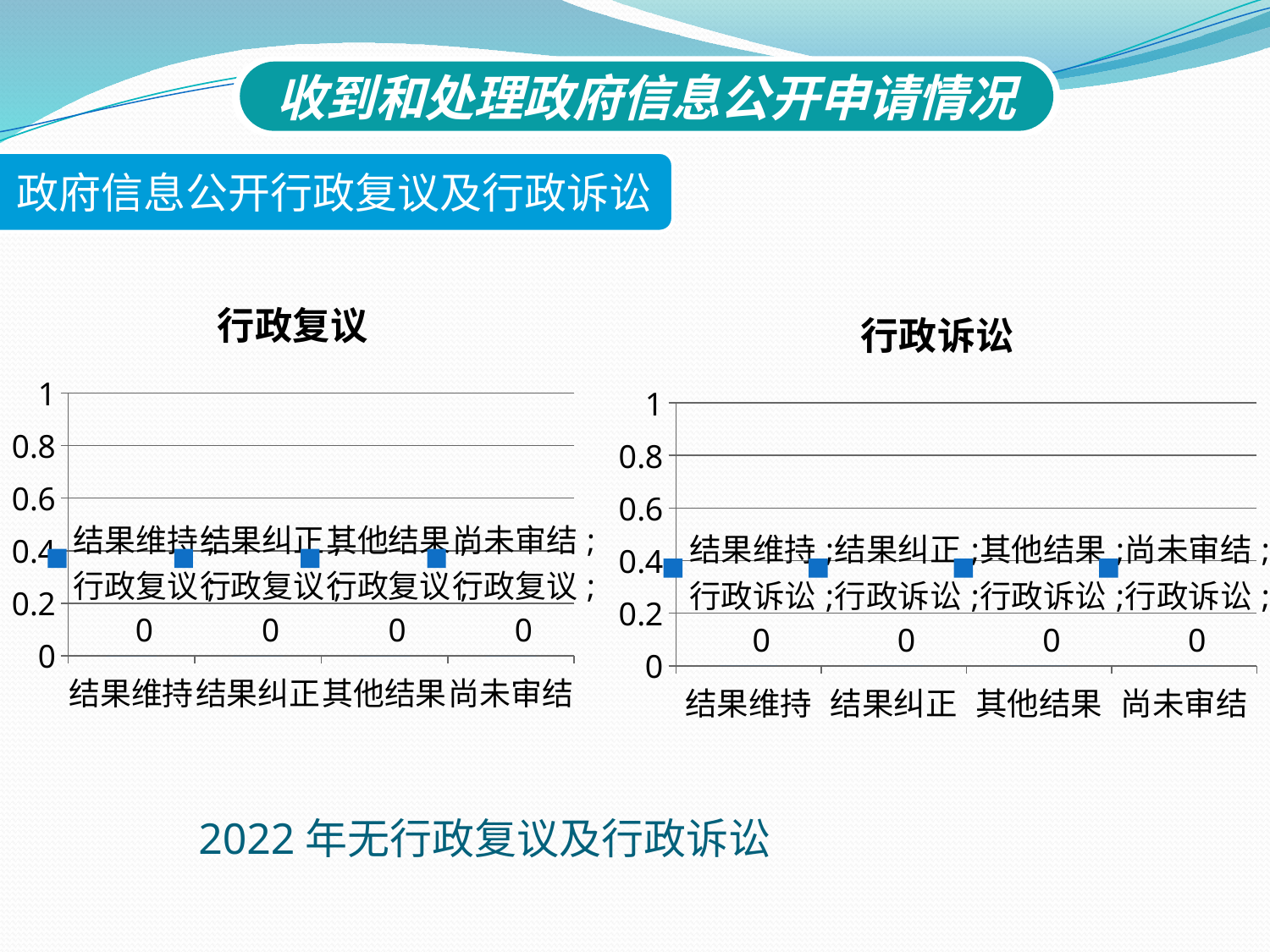
In the 行政诉讼 chart, is the value for 结果纠正 greater or less than 0.2? less What is the highest value shown on the y axis of the 行政诉讼 chart? 1 In the 行政诉讼 chart, what is the value for 其他结果? 0 How many categories are shown on the x axis of the 行政复议 chart? 4 What is the title of the chart on the left side of the slide? 行政复议 In the 行政诉讼 chart, what is the value for 尚未审结? 0 In the 行政诉讼 chart, what is the value for 结果维持? 0 How many categories are shown on the x axis of the 行政诉讼 chart? 4 In the 行政复议 chart, what is the value for 结果维持? 0 In the 行政复议 chart, what is the value for 尚未审结? 0 In the 行政复议 chart, what is the value for 结果纠正? 0 In the 行政复议 chart, what is the value for 其他结果? 0